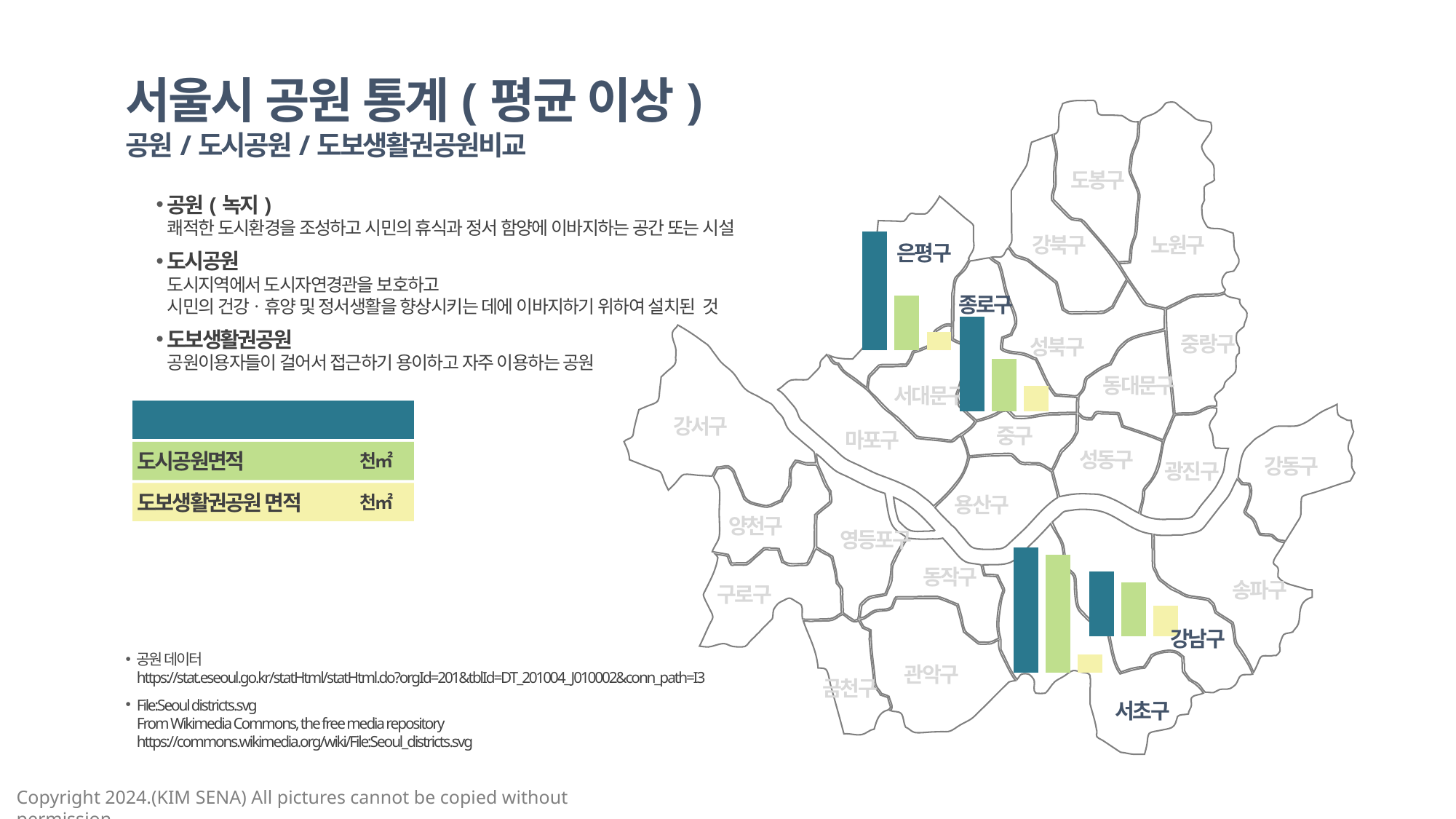
Which colour does the legend assign to 도시공원면적? light green What unit does the legend give for 도보생활권공원 면적? 천㎡ How many colour entries does the legend on the left list? 3 In the bar chart on 은평구, which series has the shortest bar? 도보생활권공원 면적 In the bar chart on 종로구, which bar is the tallest? the dark teal bar In the bar chart above the 서초구 label, which is taller: the dark teal bar or the light green bar? the dark teal bar In the bar chart next to the 강남구 label, which is taller: the 도시공원면적 bar or the 도보생활권공원 면적 bar? the 도시공원면적 bar What kind of chart is overlaid on the districts of the Seoul map? bar chart How many bars are drawn in the bar chart on 은평구? 3 In the bar chart on 은평구, which is taller: the dark teal bar or the pale yellow bar? the dark teal bar How many districts on the map have a bar chart drawn on them? 4 In the bar chart on 종로구, which series has the shortest bar? 도보생활권공원 면적